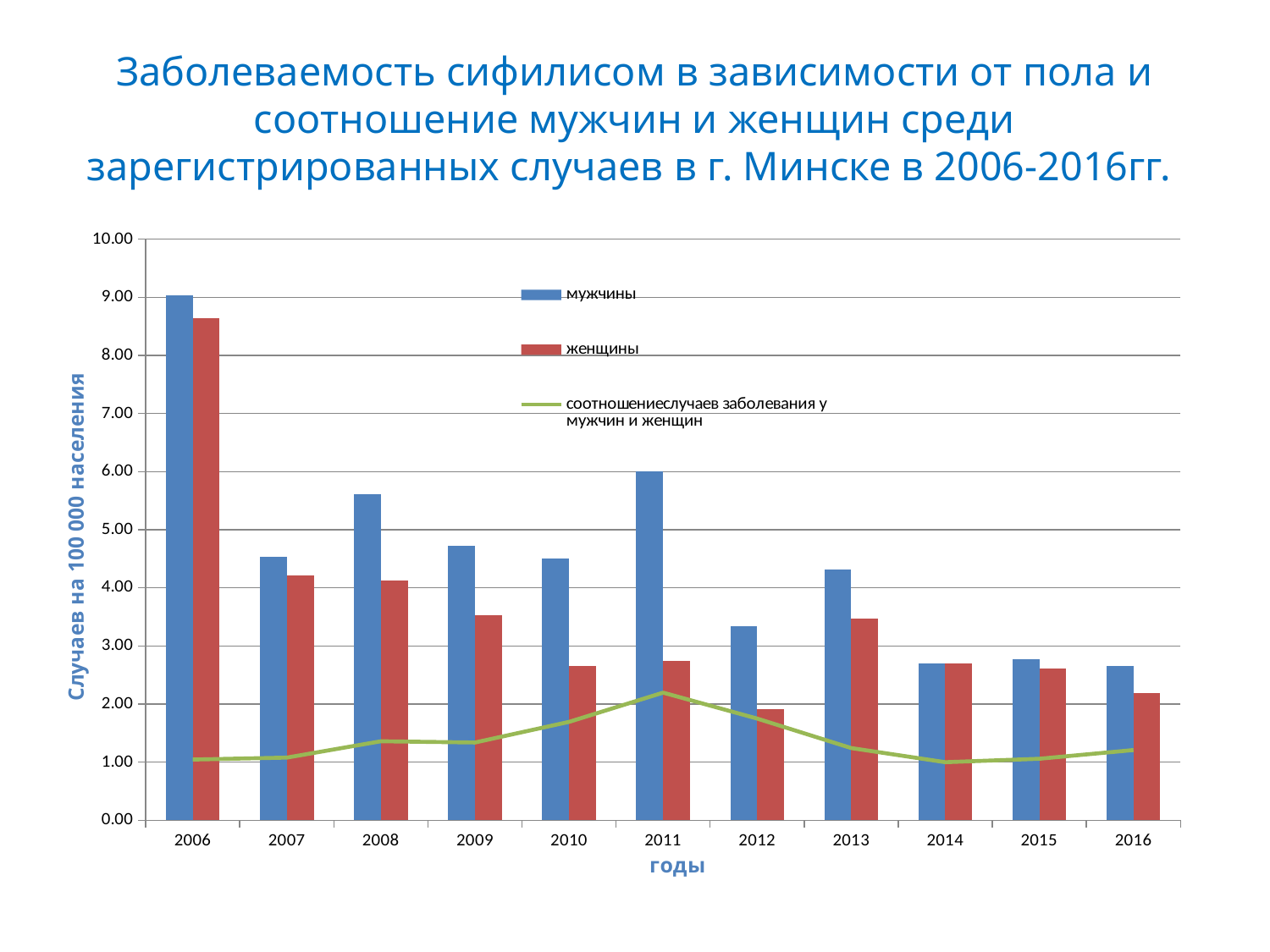
Is the value for женщины in 2010 greater or less than 3.00? less In 2013, which is larger: the value for мужчины or the value for женщины? мужчины What kind of chart is shown on the slide? combination bar and line chart How many years are shown on the x axis? 11 In which year is the value for женщины lowest? 2012 How many series does the legend list? 3 In which year does the line соотношение случаев заболевания у мужчин и женщин reach its highest point? 2011 Is the value for мужчины in 2008 greater or less than 5.00? greater Is the value for мужчины in 2011 greater or less than 5.00? greater In which year is the value for мужчины highest? 2006 Do the values for мужчины generally rise or fall from 2006 to 2016? fall In which year is the value for женщины highest? 2006